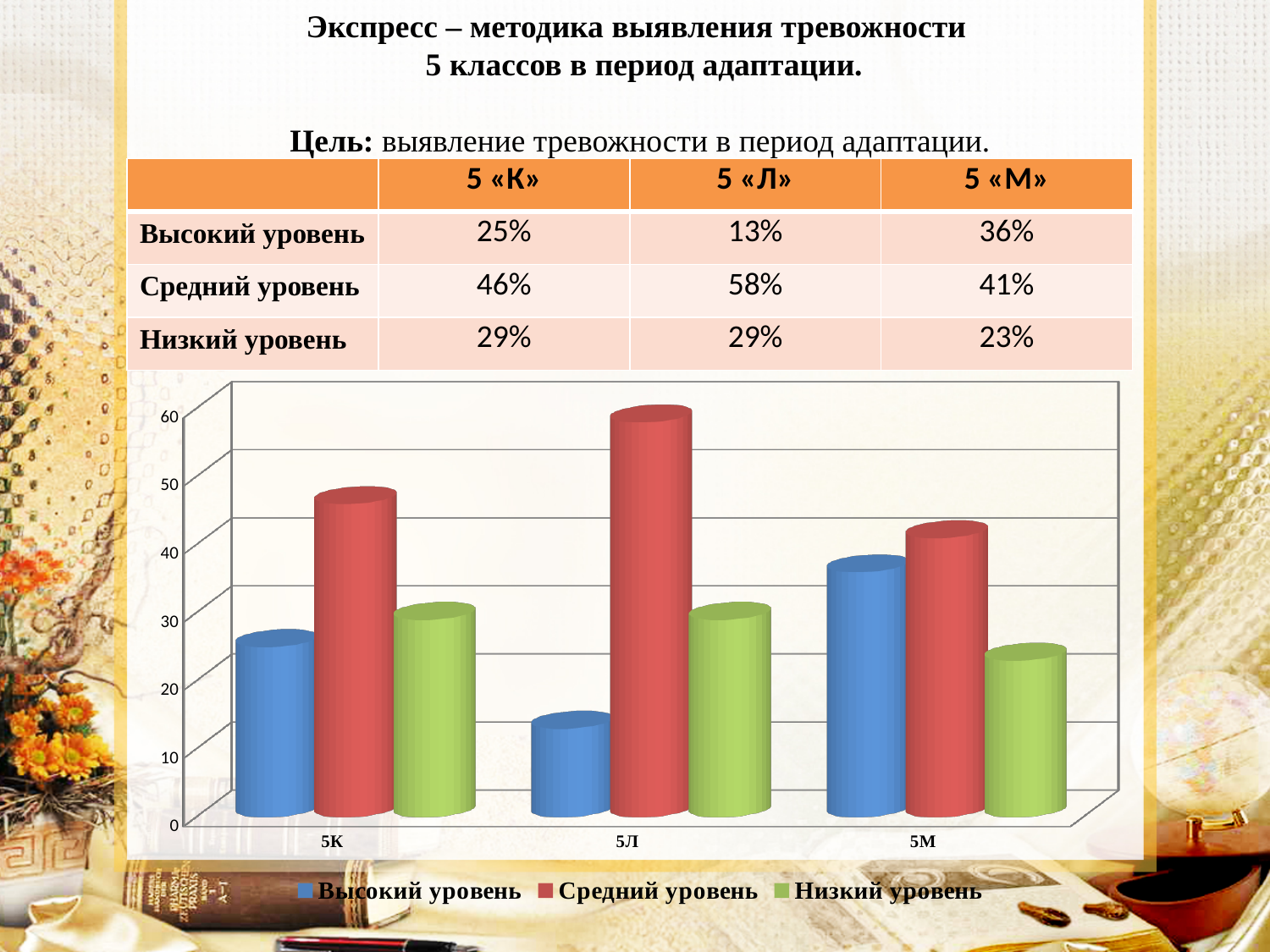
According to the slide, what is the value of Средний уровень for 5 «Л»? 58% What kind of chart is shown on the slide? bar chart Which class has the highest value for Средний уровень? 5Л In the chart, is the Средний уровень bar for 5Л greater or less than 50? greater According to the slide, what is the value of Низкий уровень for 5 «К»? 29% How many series does the chart legend list? 3 According to the slide, what is the value of Высокий уровень for 5 «М»? 36% Which is larger: Высокий уровень for 5 «К» or Высокий уровень for 5 «М»? Высокий уровень for 5 «М» How many classes (categories) are shown on the x axis of the chart? 3 Which legend entry is shown in red in the chart? Средний уровень What is the difference between Средний уровень for 5 «Л» and Средний уровень for 5 «М»? 17% Which class has the lowest value for Высокий уровень? 5Л